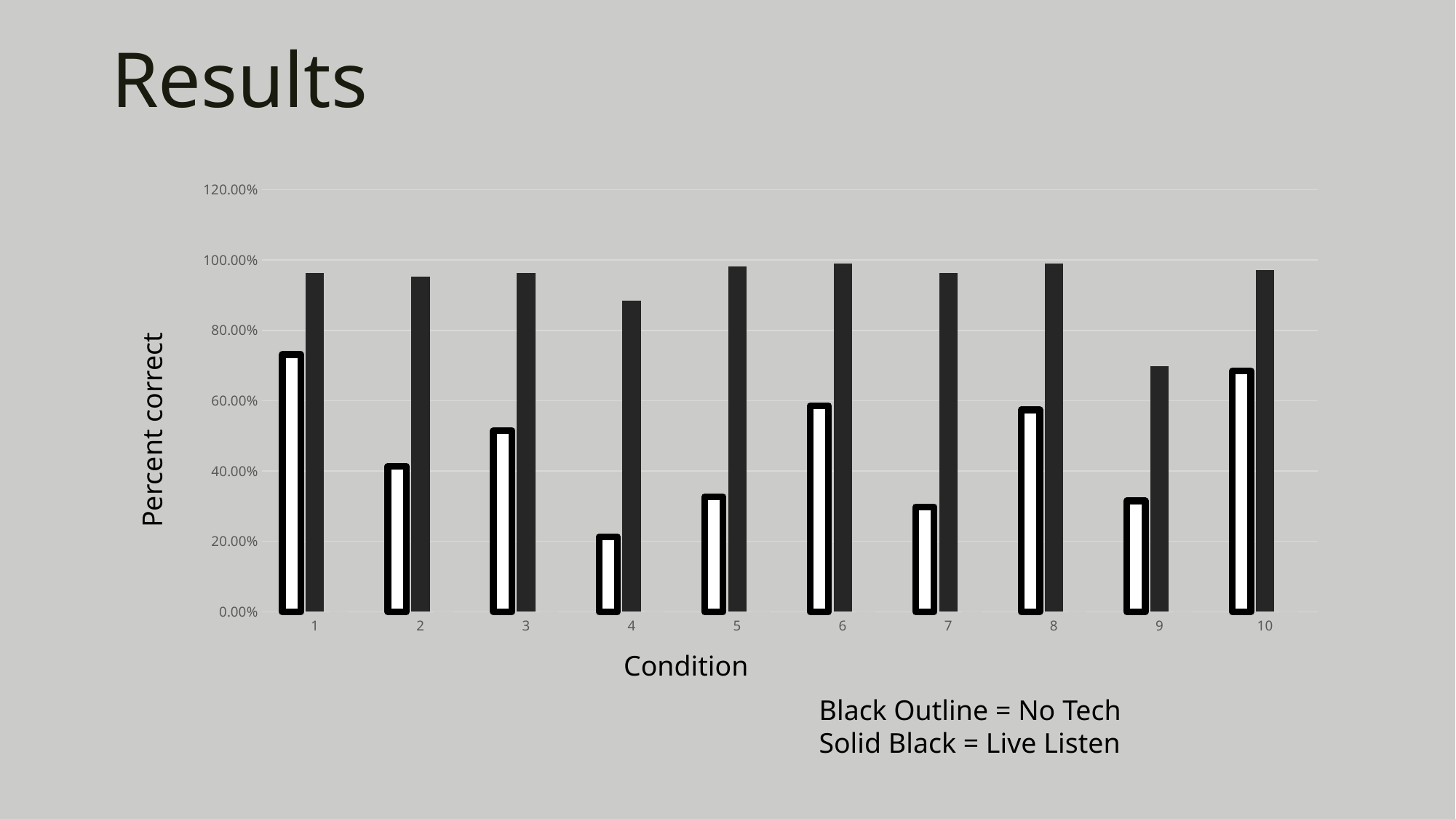
What does the solid black bar represent in the chart? Live Listen Is the No Tech value for condition 4 greater or less than 40.00%? less Is the Live Listen value for condition 9 greater or less than 80.00%? less What kind of chart is shown on the slide? Bar chart Which condition has the lowest No Tech (black outline) value? 4 Which is larger: the No Tech value for condition 2 or the No Tech value for condition 3? Condition 3 What is the label of the y axis of the chart? Percent correct Is the No Tech value for condition 1 greater or less than 60.00%? greater How many conditions are shown on the x axis of the chart? 10 Which condition has the lowest Live Listen (solid black) value? 9 For condition 4, which is larger: the No Tech value or the Live Listen value? Live Listen How many series does the chart show? 2